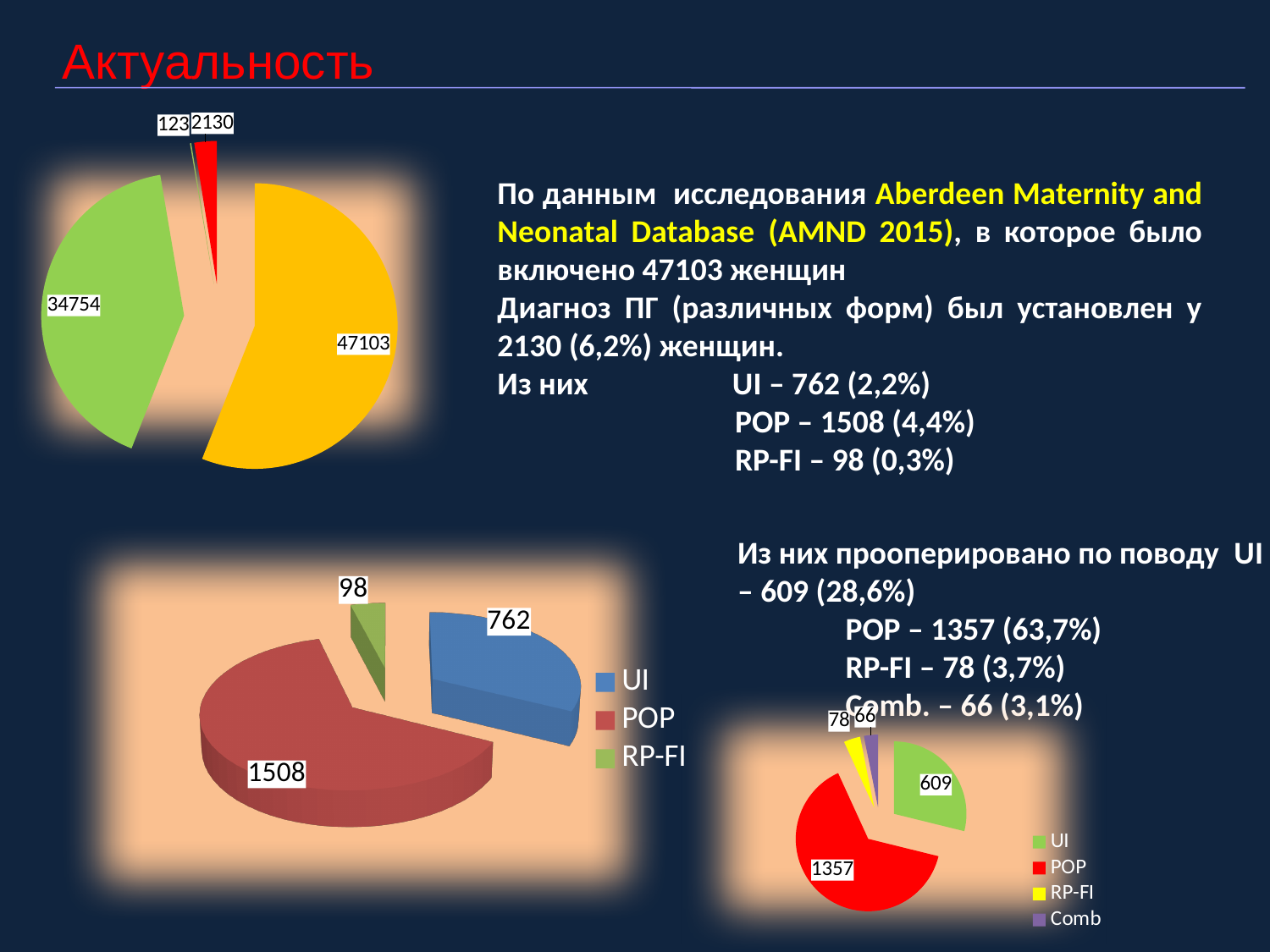
In the bottom-left pie chart, what is the value for UI? 762 In the bottom-left pie chart, what is the value for POP? 1508 What kind of chart is the bottom-left chart with the UI, POP and RP-FI legend? pie chart In the top-left pie chart, what is the largest value shown? 47103 How many entries does the legend of the bottom-left pie chart list? 3 In the bottom-right pie chart, what is the value for Comb? 66 In the bottom-left pie chart, which category has the largest slice? POP In the bottom-right pie chart, what is the value for POP? 1357 How many categories does the bottom-right pie chart show? 4 In the bottom-right pie chart, which is larger, RP-FI or Comb? RP-FI In the bottom-left pie chart, which category has the smallest slice? RP-FI In the bottom-left pie chart, what is the difference between the POP value and the UI value? 746